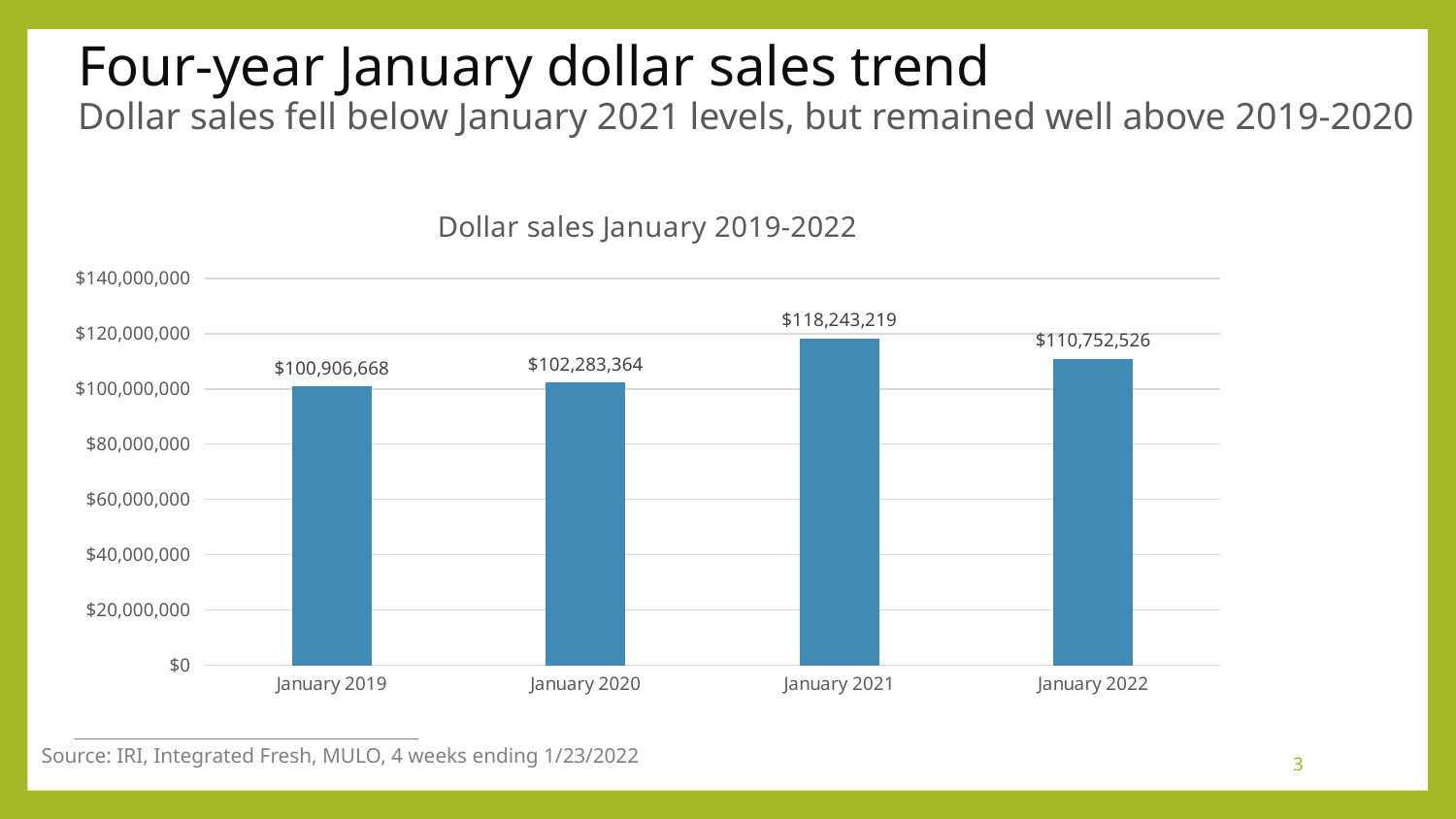
What kind of chart is shown on the slide? bar chart What is the difference in dollar sales between January 2021 and January 2022? $7,490,693 Which January has the lowest dollar sales? January 2019 Which is larger, dollar sales in January 2022 or January 2020? January 2022 What is the dollar sales value for January 2022? $110,752,526 What is the dollar sales value for January 2019? $100,906,668 What is the dollar sales value for January 2021? $118,243,219 How many Januaries are shown on the chart? 4 Is the value for January 2021 greater or less than $120,000,000? less Which January has the highest dollar sales? January 2021 What is the title of the chart? Dollar sales January 2019-2022 What is the difference in dollar sales between January 2020 and January 2019? $1,376,696